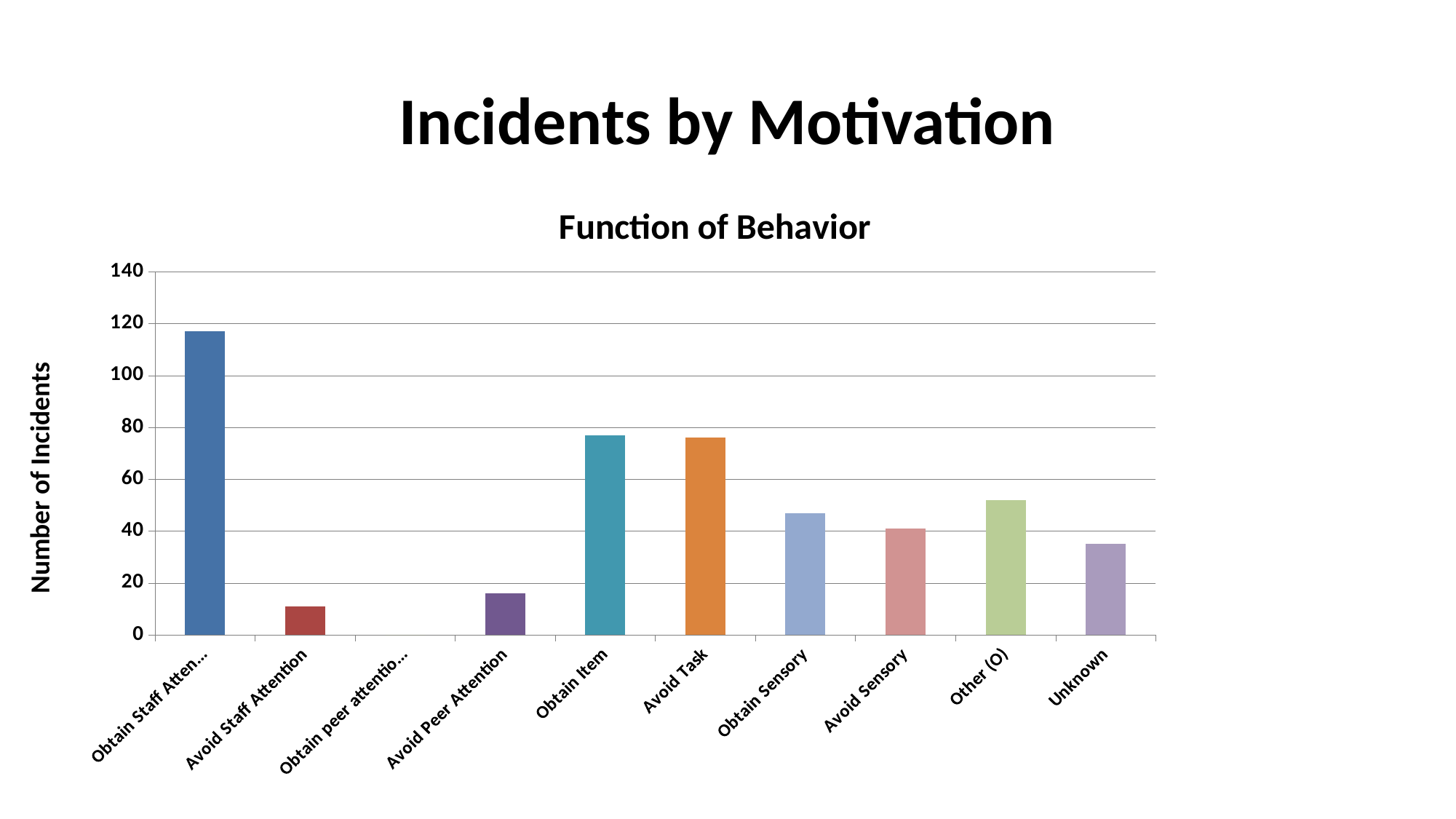
Which is larger, the value for Avoid Peer Attention or the value for Avoid Staff Attention? Avoid Peer Attention Is the value for Obtain Item greater or less than 60? greater How many categories are shown on the x axis of the chart? 10 Is the value for Avoid Staff Attention greater or less than 20? less Is the value for Avoid Sensory greater or less than 60? less What is the title of the chart? Function of Behavior What is the label on the vertical axis of the chart? Number of Incidents Which is larger, the value for Avoid Sensory or the value for Unknown? Avoid Sensory What kind of chart is shown on the slide? bar chart